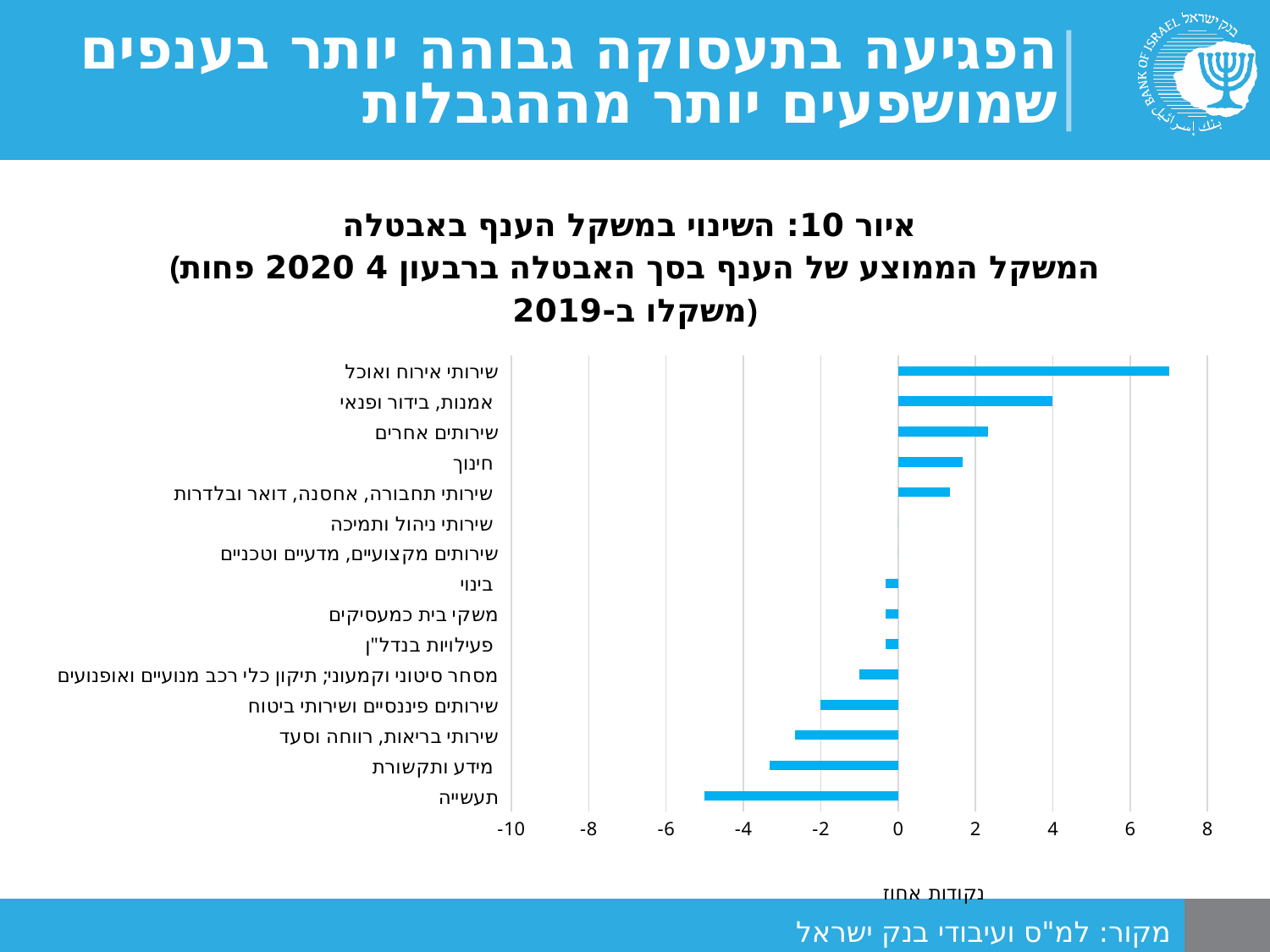
Is the value for מידע ותקשורת greater or less than -2? less Is the value for תעשייה greater or less than -4? less What unit is given for the horizontal axis of the chart? נקודות אחוז How many industry categories are plotted in the chart? 15 Which has the larger value: מידע ותקשורת or תעשייה? מידע ותקשורת Is the value for שירותי בריאות, רווחה וסעד greater or less than 0? less Which has the larger value: שירותי אירוח ואוכל or אמנות, בידור ופנאי? שירותי אירוח ואוכל Which category has the lowest value in the chart? תעשייה Which category has the highest value in the chart? שירותי אירוח ואוכל What kind of chart is shown on the slide? Bar chart